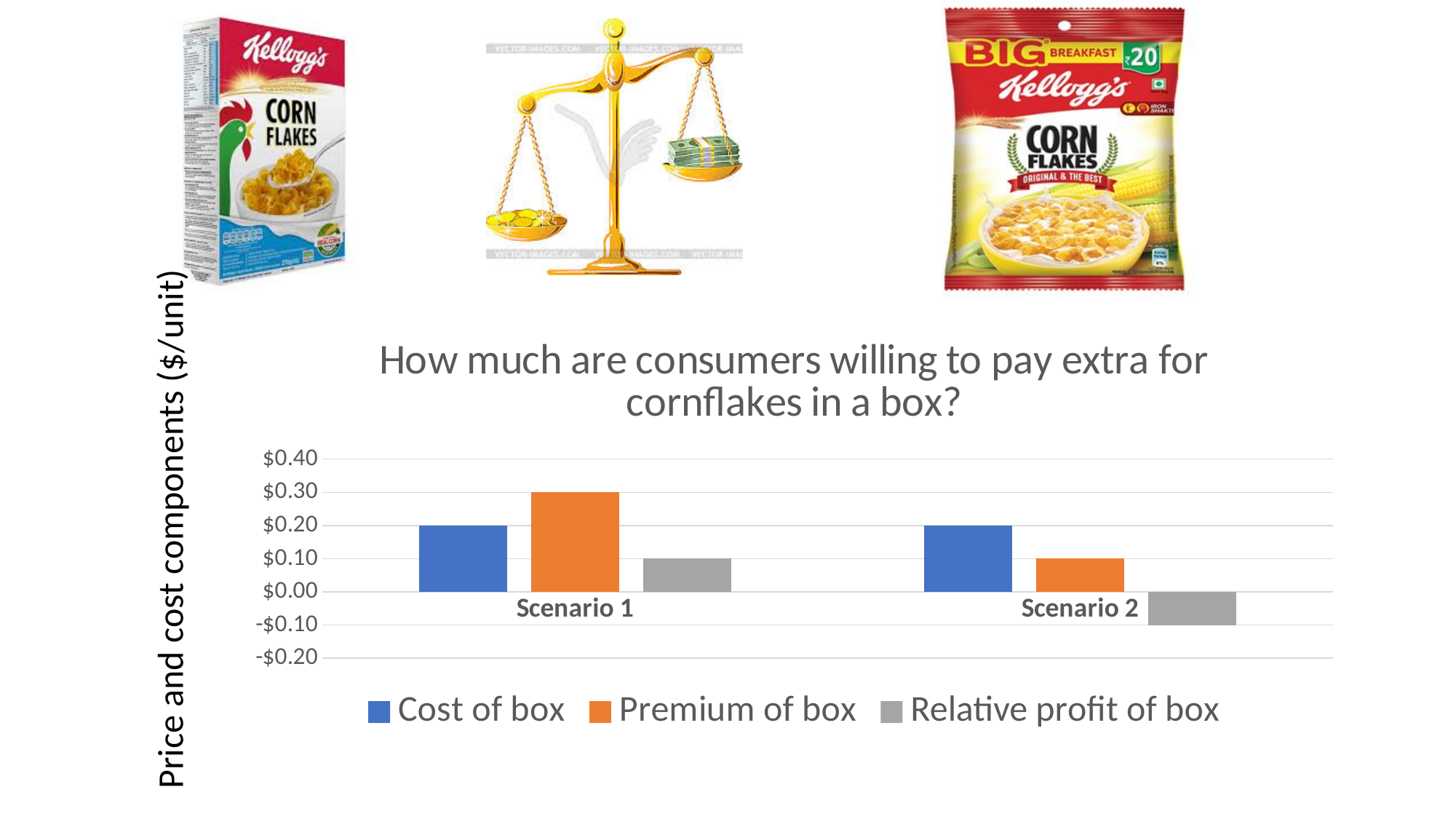
What is the title of the chart? How much are consumers willing to pay extra for cornflakes in a box? What is the value of Relative profit of box in Scenario 2? -$0.10 Which is larger: Relative profit of box in Scenario 1 or Relative profit of box in Scenario 2? Scenario 1 How many series does the legend list? 3 How many scenarios (categories) are shown on the x axis? 2 What is the value of Premium of box in Scenario 1? $0.30 What kind of chart is shown on the slide? bar chart What is the value of Cost of box in Scenario 2? $0.20 What is the difference between Premium of box in Scenario 1 and Premium of box in Scenario 2? $0.20 Which series is shown in orange in the legend? Premium of box Which series has the highest value in Scenario 1? Premium of box Which series has the lowest value in Scenario 2? Relative profit of box